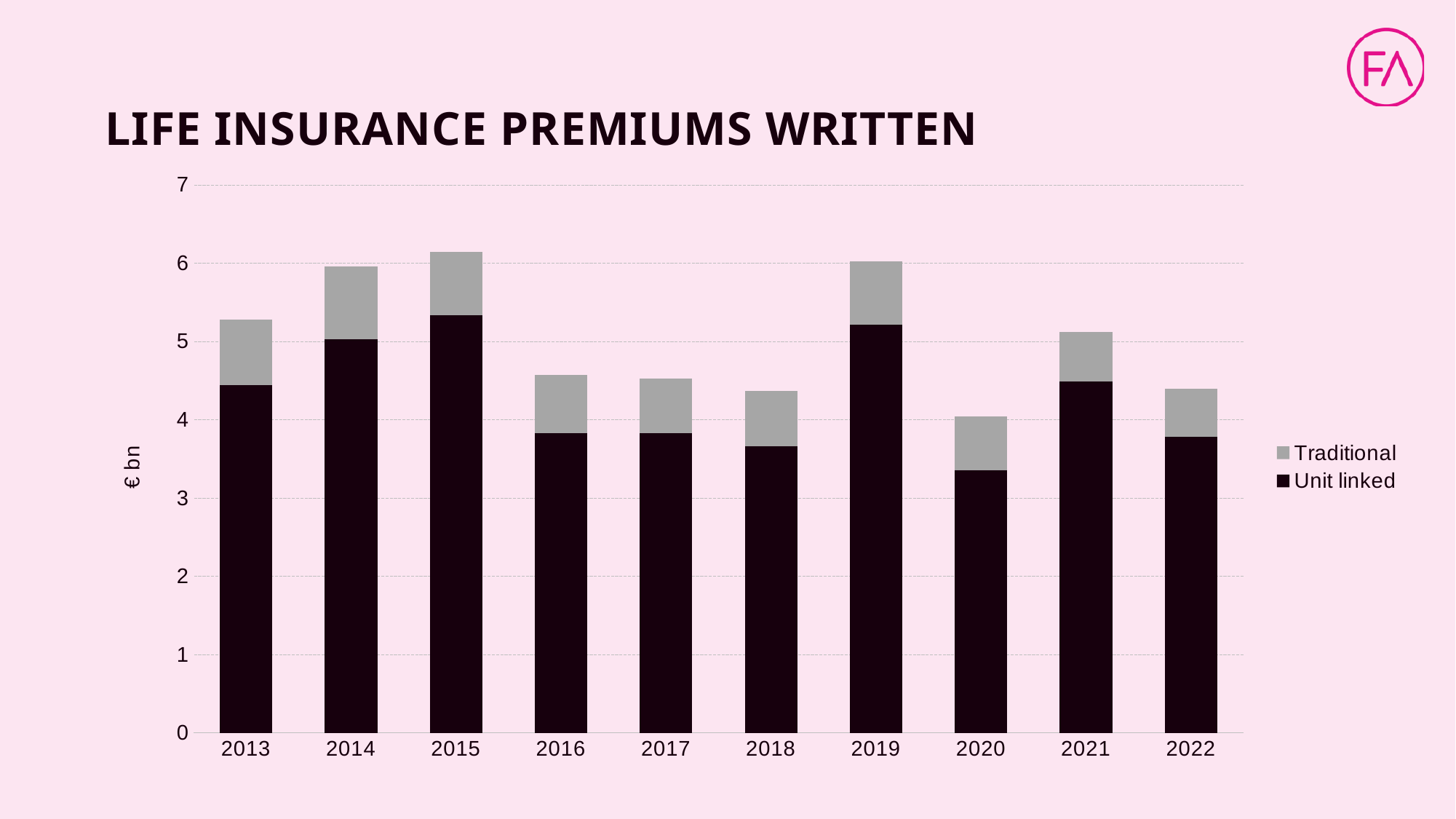
What kind of chart is shown on the slide? Stacked bar chart What unit is shown on the y axis of the chart? € bn How many years are shown on the x axis of the chart? 10 Is the total value for 2022 greater or less than 5? less Which year has the lowest Unit linked value? 2020 Is the Unit linked value for 2020 greater or less than 4? less Which year has the highest total life insurance premiums written? 2015 Is the total value for 2019 larger than the total value for 2020? Yes How many series does the legend list? 2 Is the total value for 2015 greater or less than 6? greater Which year has the lowest total life insurance premiums written? 2020